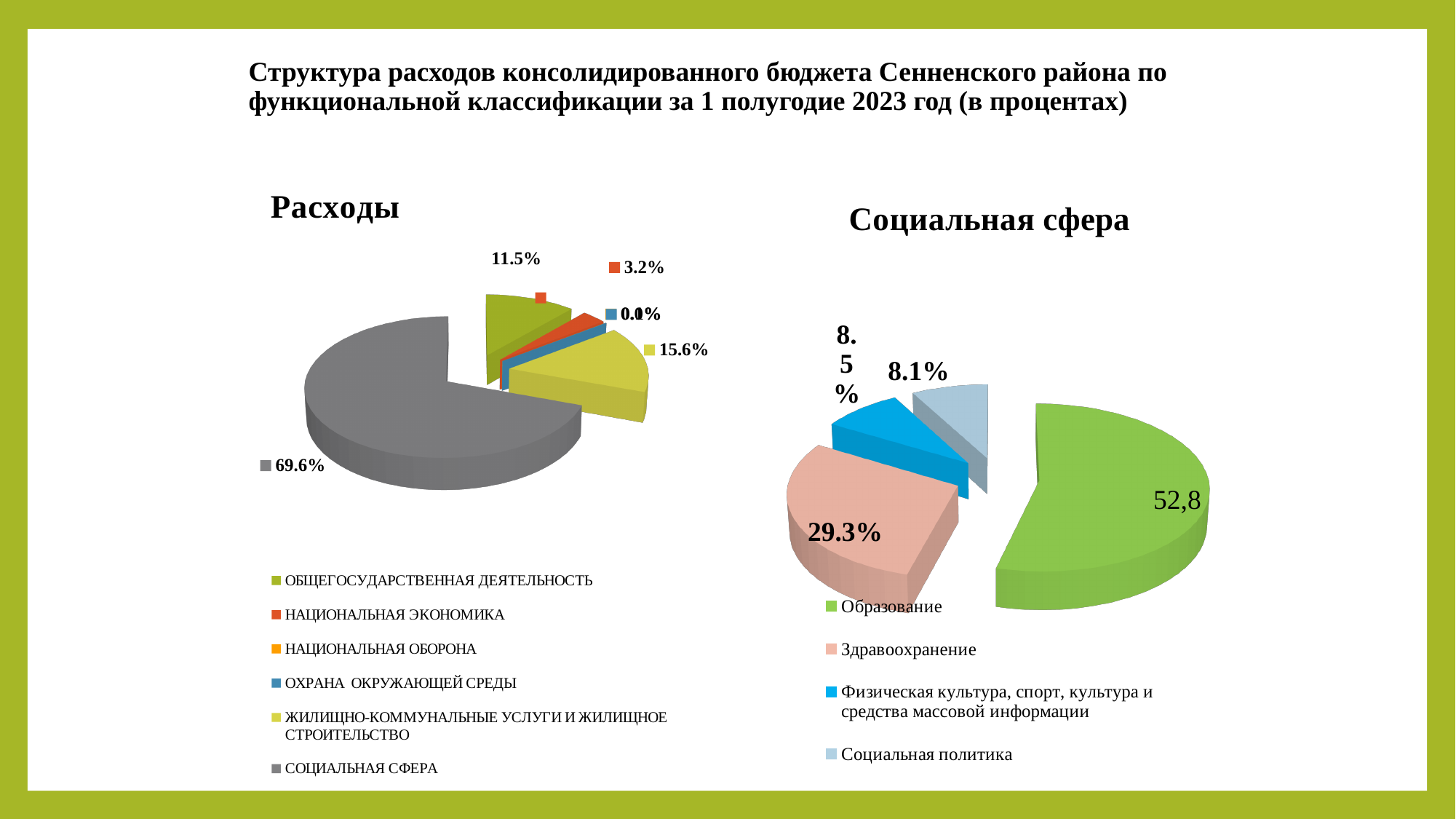
In the 'Социальная сфера' chart, what value is shown for Образование? 52,8 In the 'Расходы' chart, what percentage is shown for СОЦИАЛЬНАЯ СФЕРА? 69.6% In the 'Расходы' chart, what is the difference between the shares of СОЦИАЛЬНАЯ СФЕРА and ЖИЛИЩНО-КОММУНАЛЬНЫЕ УСЛУГИ И ЖИЛИЩНОЕ СТРОИТЕЛЬСТВО? 54.0% In the 'Социальная сфера' chart, what value is shown for Здравоохранение? 29.3% In the 'Расходы' chart, what percentage is shown for ЖИЛИЩНО-КОММУНАЛЬНЫЕ УСЛУГИ И ЖИЛИЩНОЕ СТРОИТЕЛЬСТВО? 15.6% In the 'Социальная сфера' chart, which is larger: Здравоохранение or Физическая культура, спорт, культура и средства массовой информации? Здравоохранение In the 'Социальная сфера' chart, which category has the smallest share? Социальная политика What type of chart is the 'Социальная сфера' chart? Pie chart In the 'Социальная сфера' chart, what colour is the Образование slice? Green In the 'Расходы' chart, how many categories does the legend list? 6 In the 'Расходы' chart, which category has the largest share? СОЦИАЛЬНАЯ СФЕРА In the 'Расходы' chart, what percentage is shown for НАЦИОНАЛЬНАЯ ЭКОНОМИКА? 3.2%